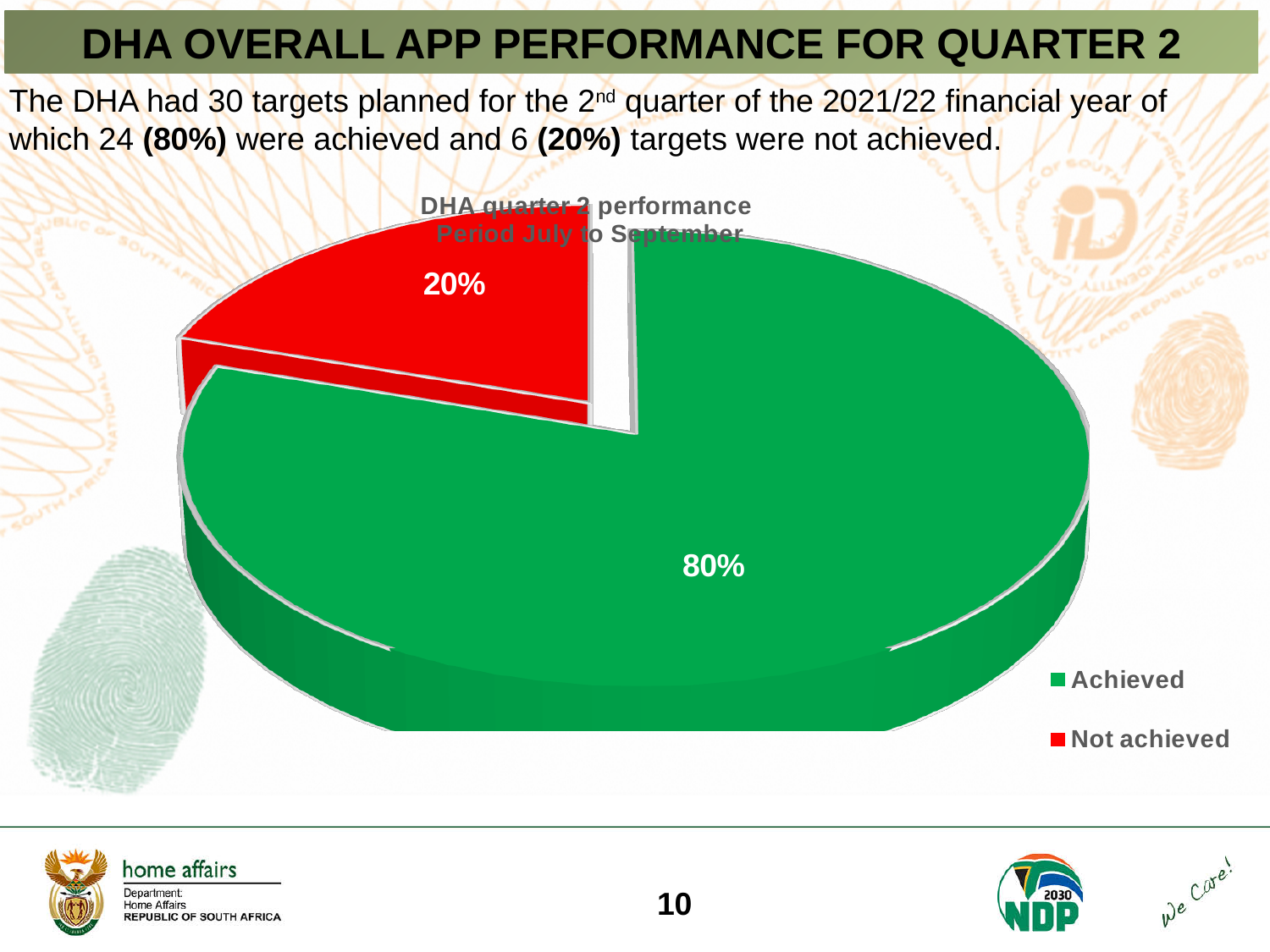
What percentage of targets were not achieved according to the pie chart? 20% Which category has the largest slice of the pie chart? Achieved Which category has the smallest slice of the pie chart? Not achieved What kind of chart is shown on the slide? Pie chart What share of the pie does the Not achieved slice represent? 20% What percentage of targets were achieved according to the pie chart? 80% Which slice is larger, Achieved or Not achieved? Achieved What is the difference in percentage points between the Achieved and Not achieved slices? 60 How many slices does the pie chart have? 2 How many entries does the legend list? 2 What colour is the Achieved slice in the pie chart? Green What is the title of the pie chart? DHA quarter 2 performance Period July to September